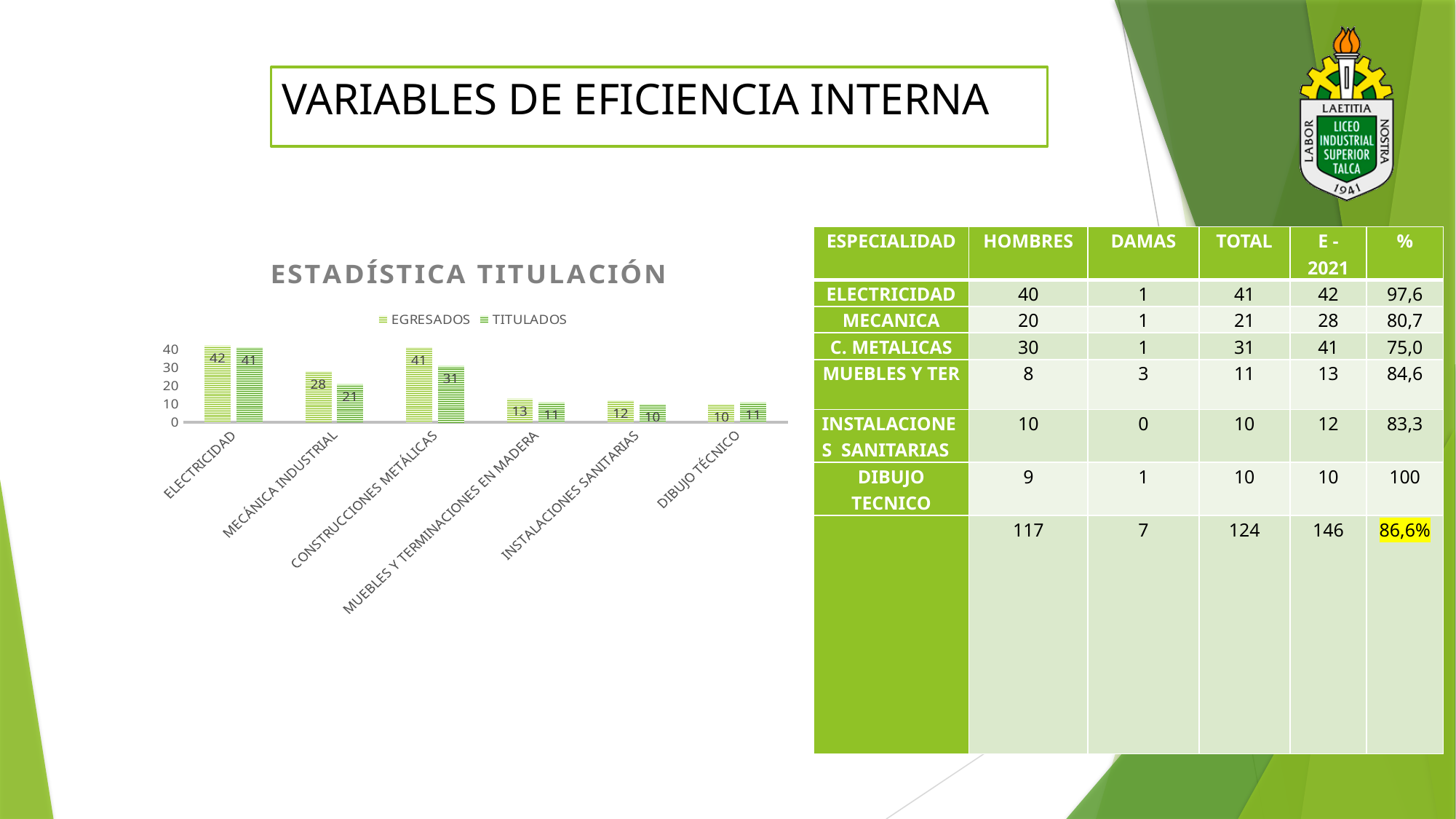
What is the EGRESADOS value for ELECTRICIDAD? 42 How many series does the chart legend list? 2 What is the title of the chart? ESTADÍSTICA TITULACIÓN How many categories are shown on the x axis of the chart? 6 Which category has the highest EGRESADOS value? ELECTRICIDAD What is the difference between EGRESADOS and TITULADOS for CONSTRUCCIONES METÁLICAS? 10 What is the EGRESADOS value for MUEBLES Y TERMINACIONES EN MADERA? 13 What is the TITULADOS value for CONSTRUCCIONES METÁLICAS? 31 Which category has the lowest TITULADOS value? INSTALACIONES SANITARIAS Which is larger for DIBUJO TÉCNICO, EGRESADOS or TITULADOS? TITULADOS What kind of chart is shown on the slide? Bar chart What is the TITULADOS value for MECÁNICA INDUSTRIAL? 21